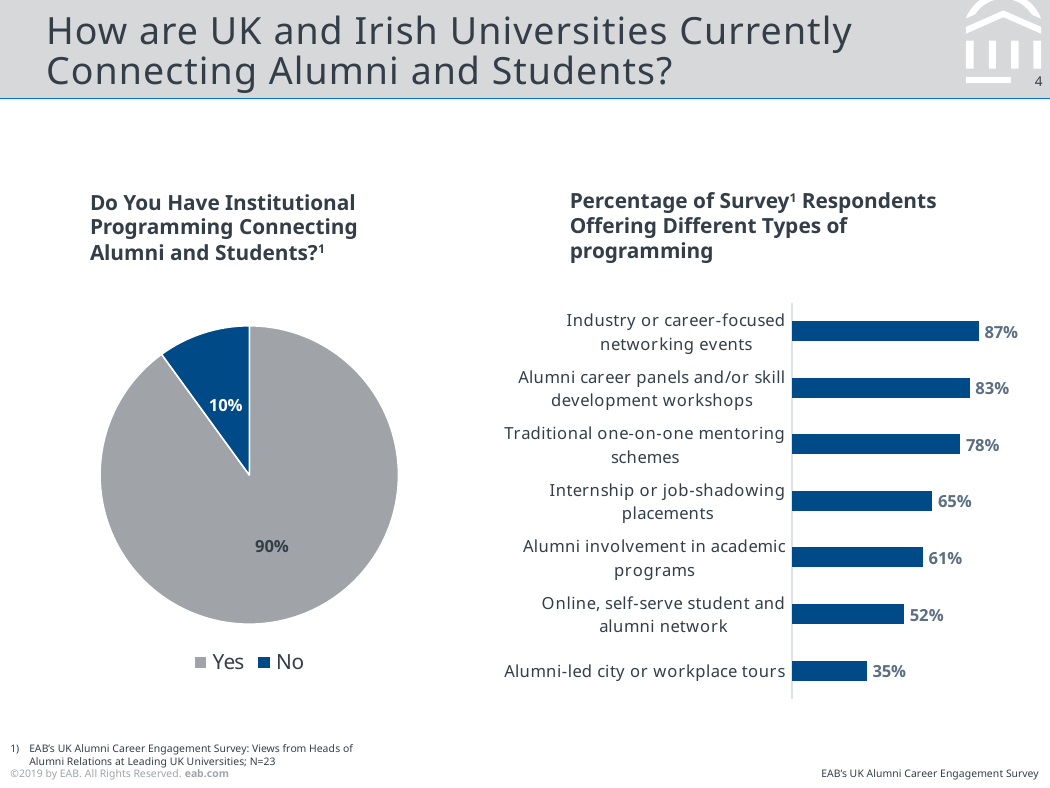
In the bar chart 'Percentage of Survey Respondents Offering Different Types of programming', what is the value for Online, self-serve student and alumni network? 52% In the pie chart 'Do You Have Institutional Programming Connecting Alumni and Students?', what share of respondents answered Yes? 90% In the bar chart 'Percentage of Survey Respondents Offering Different Types of programming', what is the value for Internship or job-shadowing placements? 65% In the bar chart 'Percentage of Survey Respondents Offering Different Types of programming', which category has the lowest value? Alumni-led city or workplace tours How many categories are shown in the bar chart 'Percentage of Survey Respondents Offering Different Types of programming'? 7 What kind of chart is the chart on the left of the slide? Pie chart In the pie chart 'Do You Have Institutional Programming Connecting Alumni and Students?', what share of respondents answered No? 10% In the bar chart 'Percentage of Survey Respondents Offering Different Types of programming', what is the difference between Alumni career panels and/or skill development workshops and Traditional one-on-one mentoring schemes? 5% What kind of chart is the chart on the right of the slide? Bar chart How many entries does the legend of the pie chart on the left list? 2 In the bar chart 'Percentage of Survey Respondents Offering Different Types of programming', which category has the highest value? Industry or career-focused networking events In the bar chart 'Percentage of Survey Respondents Offering Different Types of programming', which is larger: Alumni involvement in academic programs or Online, self-serve student and alumni network? Alumni involvement in academic programs